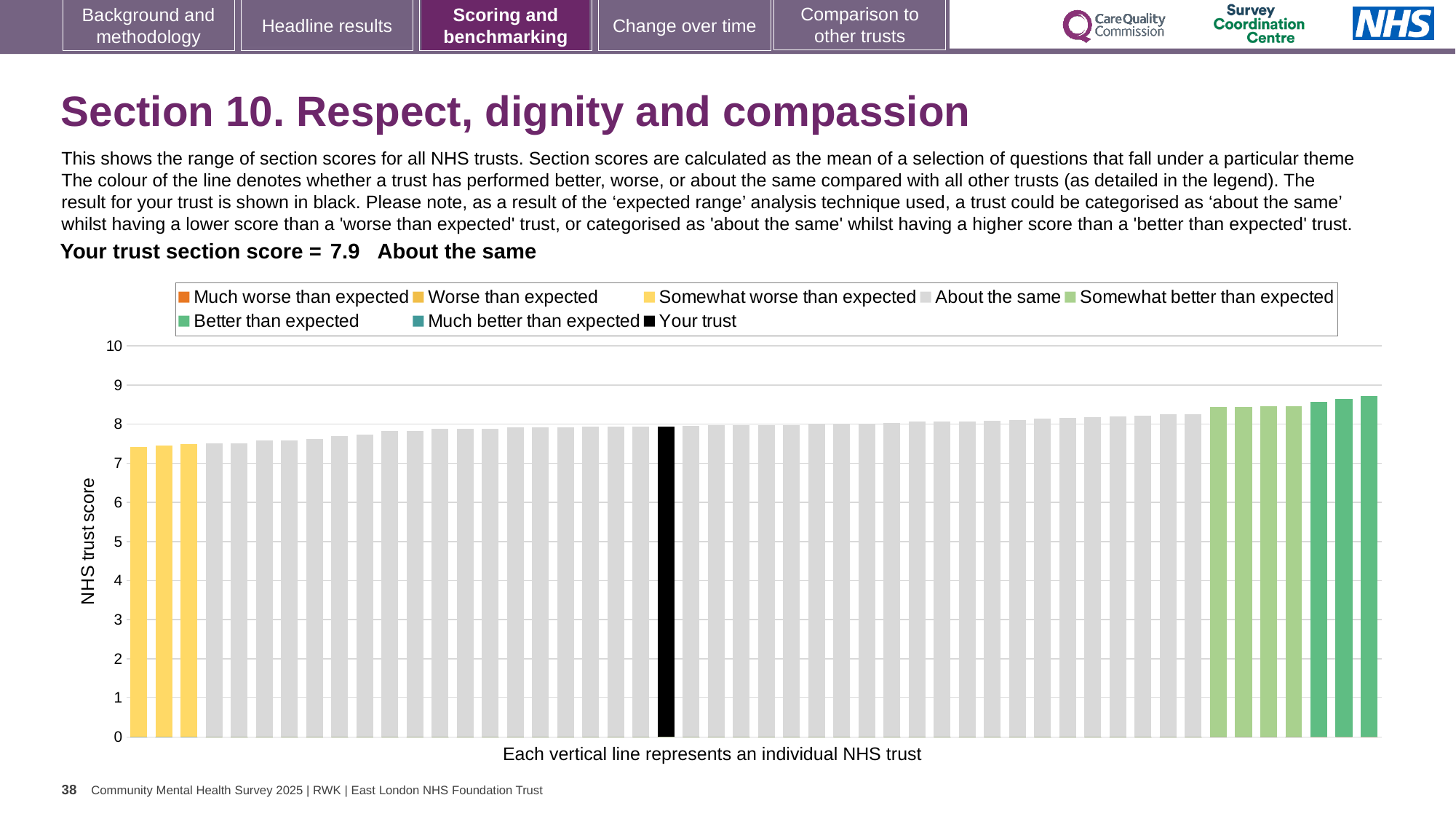
Which category does your trust fall into according to the slide? About the same What kind of chart is shown on the slide? bar chart Which is taller: the black bar for your trust or the rightmost bar? the rightmost bar How many entries does the chart legend list? 8 How many bars are coloured dark green (Better than expected)? 3 Is the value of the tallest bar greater or less than 9? less Is the value of the leftmost bar greater or less than 8? less How many bars are coloured yellow (Somewhat worse than expected)? 3 Is the value of the black bar (your trust) greater or less than 7? greater What is the title of the y axis? NHS trust score What is the section score for your trust shown on the slide? 7.9 Do the bar values rise or fall from left to right along the x axis? rise